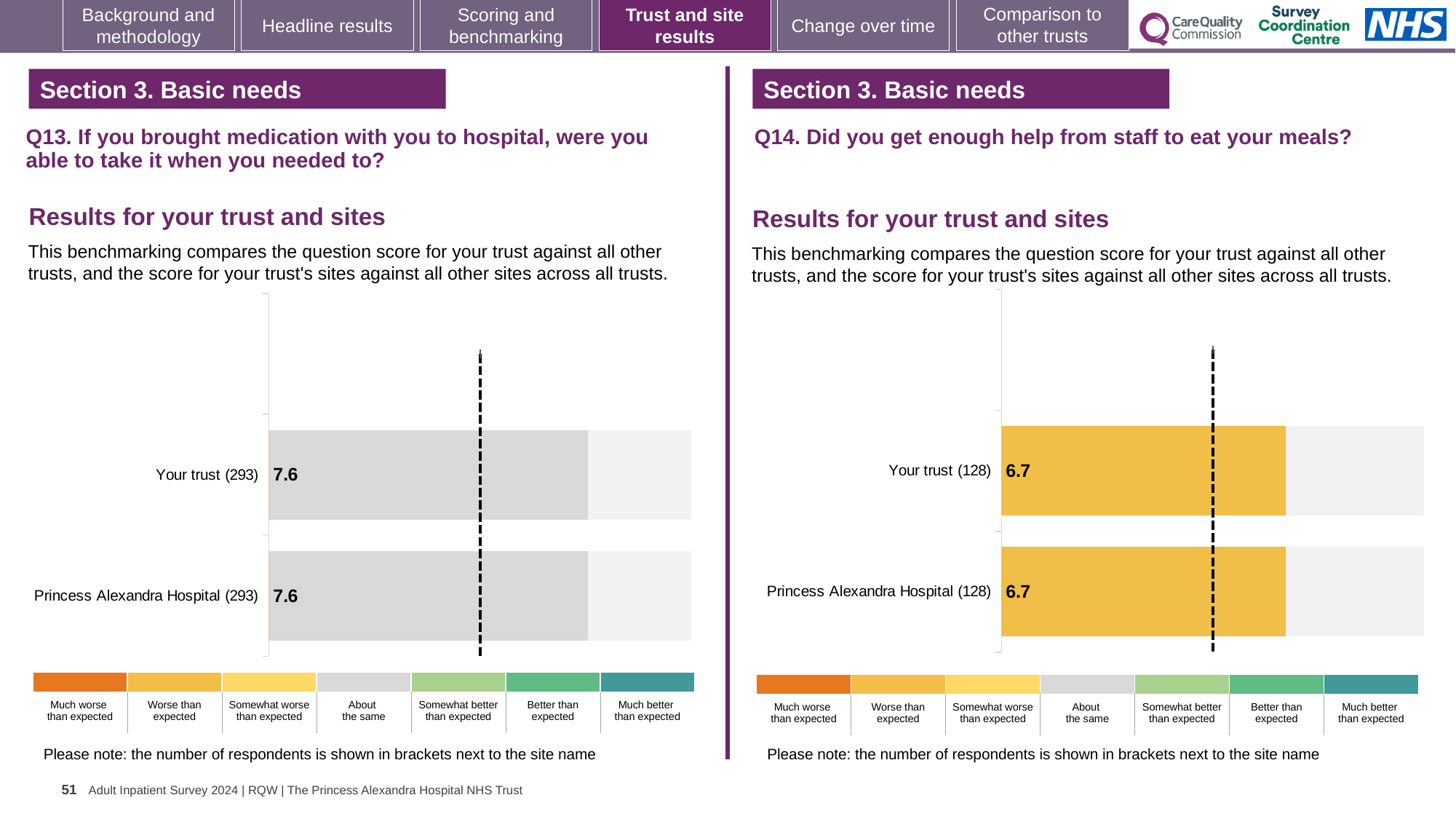
What kind of chart is used for the Q14 results on the right? Bar chart In the Q13 chart on the left, what is the score for Your trust? 7.6 According to the colour key, which benchmark category do the yellow bars in the Q14 chart on the right represent? Worse than expected In the Q14 chart on the right, what is the score for Princess Alexandra Hospital? 6.7 In the Q13 chart on the left, what is the difference between the score for Your trust and the score for Princess Alexandra Hospital? 0 In the Q13 chart on the left, how many respondents are shown in brackets next to Your trust? 293 How many bars are plotted in the Q14 chart on the right? 2 In the Q14 chart on the right, what is the score for Your trust? 6.7 In the Q13 chart on the left, what is the score for Princess Alexandra Hospital? 7.6 How many bars are plotted in the Q13 chart on the left? 2 In the Q14 chart on the right, how many respondents are shown in brackets next to Princess Alexandra Hospital? 128 In the Q14 chart on the right, what is the difference between the score for Your trust and the score for Princess Alexandra Hospital? 0